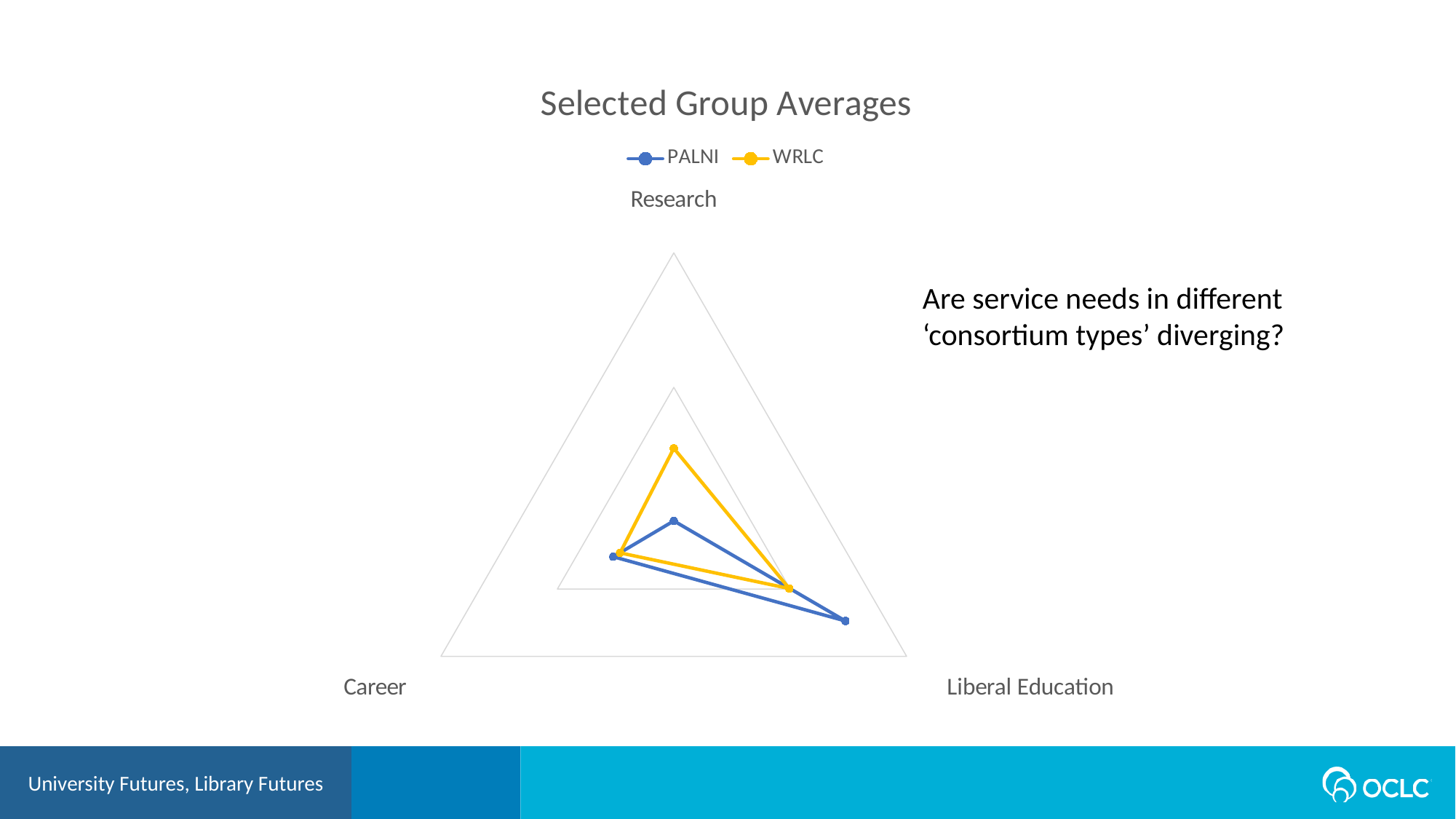
How many series does the legend list? 2 On which category does WRLC have its lowest value? Career On which category does PALNI have its highest value? Liberal Education What kind of chart is shown on the slide? Radar chart Which series has the higher value for Research, PALNI or WRLC? WRLC On which category does PALNI have its lowest value? Research Which series has the higher value for Liberal Education, PALNI or WRLC? PALNI On which category does WRLC have its highest value? Liberal Education Which colour represents the WRLC series? Yellow What is the title of the chart? Selected Group Averages How many categories (axes) does the radar chart have? 3